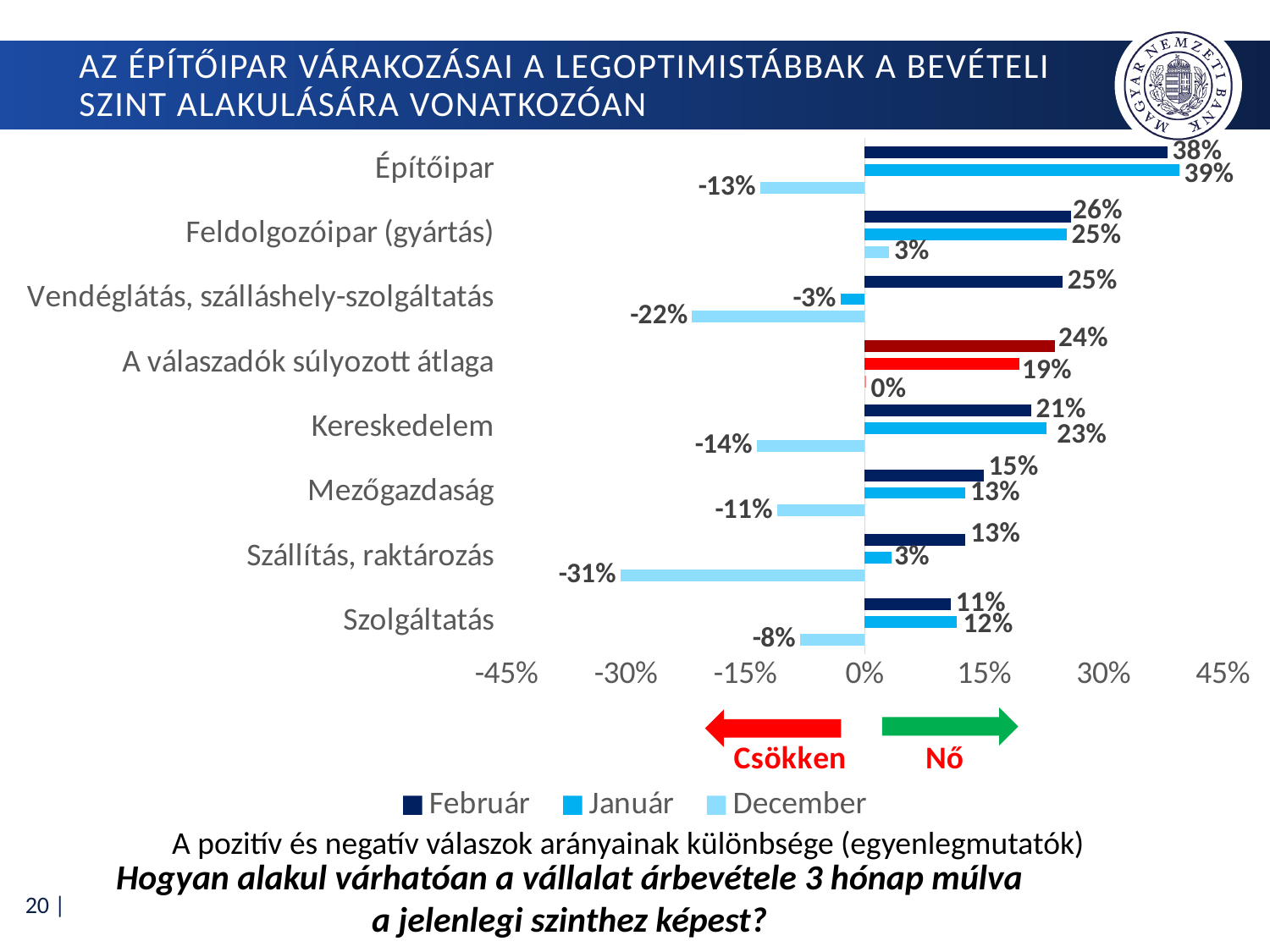
What is the December value for Szállítás, raktározás? -31% What kind of chart is shown on the slide? Bar chart Which series is shown in the lightest blue colour in the legend? December What is the December value for A válaszadók súlyozott átlaga? 0% Which category has the lowest December value? Szállítás, raktározás What is the difference between the Február and December values for Kereskedelem? 35 percentage points What is the Február value for Építőipar? 38% How many categories are shown on the chart? 8 Which category has the highest Január value? Építőipar How many series does the legend list? 3 What is the Január value for Vendéglátás, szálláshely-szolgáltatás? -3% Which is larger for Mezőgazdaság, the Február value or the Január value? Február